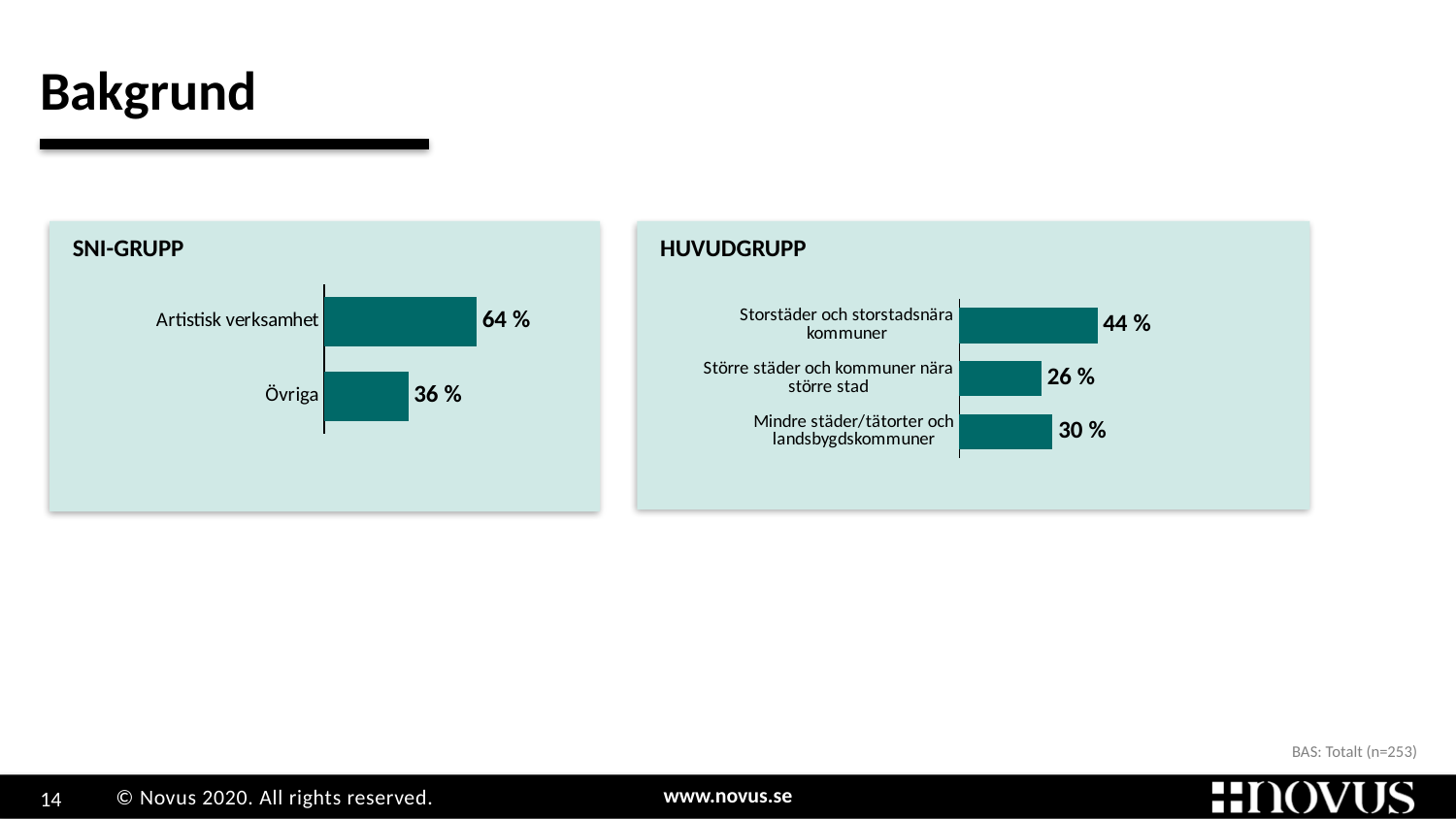
In the HUVUDGRUPP chart, which is larger: Mindre städer/tätorter och landsbygdskommuner or Större städer och kommuner nära större stad? Mindre städer/tätorter och landsbygdskommuner In the SNI-GRUPP chart, what is the value for Övriga? 36 % What kind of chart is the HUVUDGRUPP chart? Bar chart In the HUVUDGRUPP chart, which category has the lowest value? Större städer och kommuner nära större stad In the SNI-GRUPP chart, what is the difference between Artistisk verksamhet and Övriga? 28 % In the SNI-GRUPP chart, how many categories are shown? 2 In the HUVUDGRUPP chart, what is the value for Mindre städer/tätorter och landsbygdskommuner? 30 % In the HUVUDGRUPP chart, what is the value for Större städer och kommuner nära större stad? 26 % In the HUVUDGRUPP chart, what is the difference between Storstäder och storstadsnära kommuner and Mindre städer/tätorter och landsbygdskommuner? 14 % In the HUVUDGRUPP chart, which category has the highest value? Storstäder och storstadsnära kommuner In the HUVUDGRUPP chart, what is the value for Storstäder och storstadsnära kommuner? 44 % In the SNI-GRUPP chart, what is the value for Artistisk verksamhet? 64 %